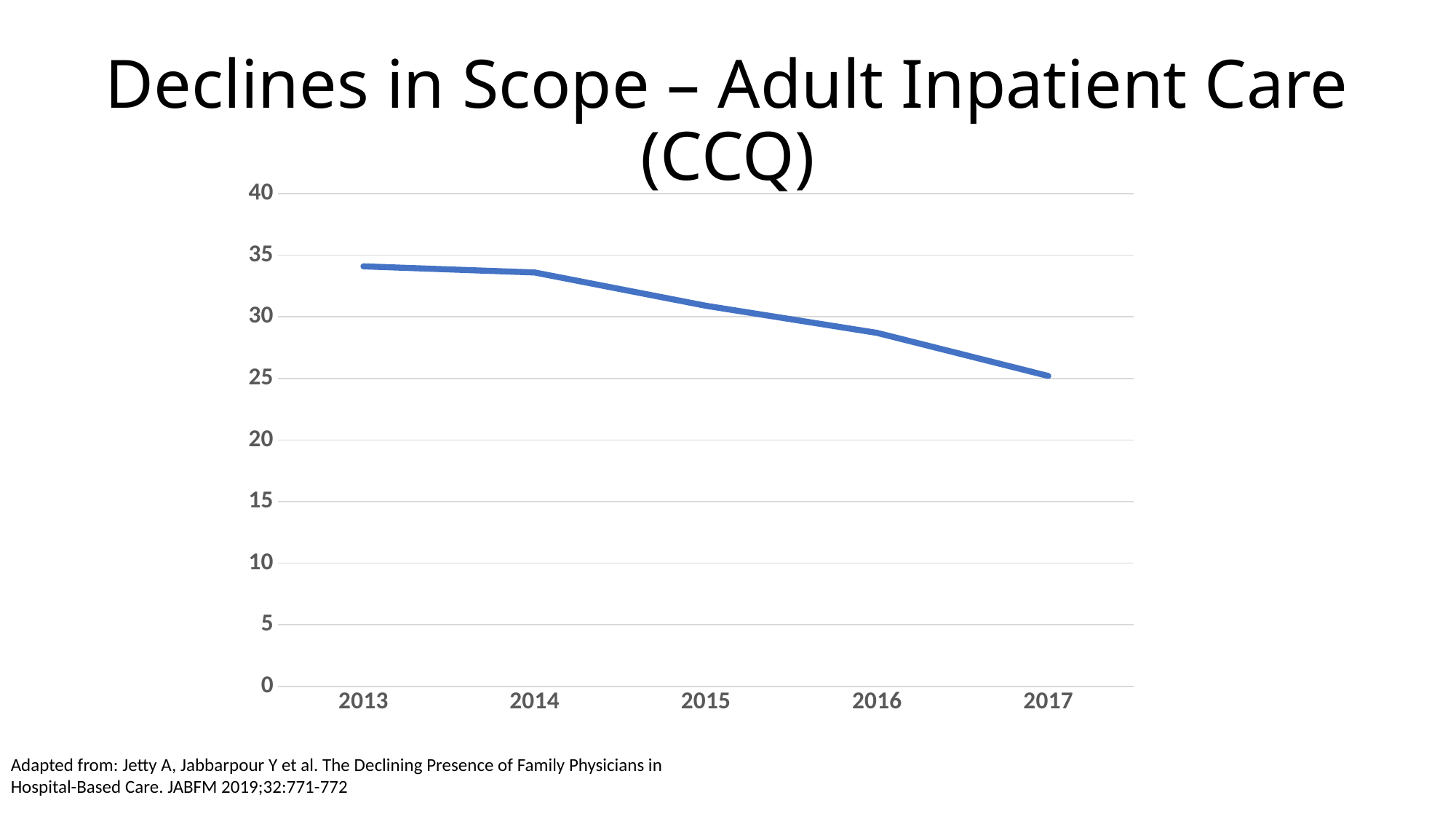
What is the first year shown on the x axis? 2013 Is the value for 2016 greater or less than 25? greater Which is larger, the value for 2013 or the value for 2017? 2013 How many years are plotted on the x axis? 5 Is the value for 2013 greater or less than 30? greater Is the value for 2017 greater or less than 30? less Which is larger, the value for 2015 or the value for 2016? 2015 What is the title of the chart? Declines in Scope – Adult Inpatient Care (CCQ) Do the values rise or fall from 2013 to 2017? fall What kind of chart is shown on the slide? line chart Which year has the lowest value? 2017